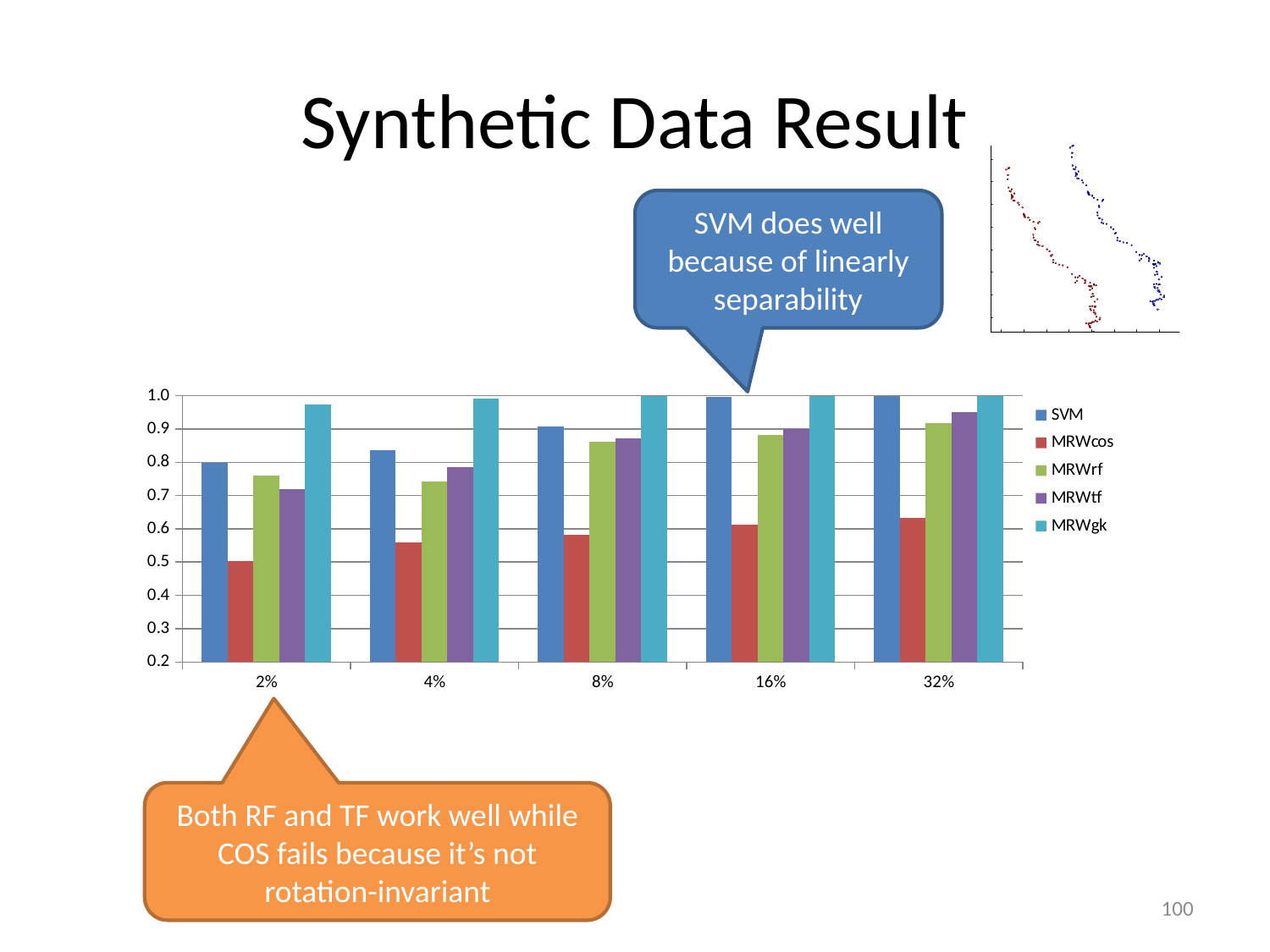
Which series is listed last in the legend? MRWgk Is the value for MRWgk at 2% greater or less than 0.9? greater Which series has the lowest value at 2%? MRWcos How many categories are shown along the x axis? 5 Is the value for MRWcos at 32% greater or less than 0.7? less Is the value for MRWcos at 2% greater or less than 0.6? less Do the MRWcos values rise or fall as the x axis goes from 2% to 32%? rise Which series has the highest value at 2%? MRWgk At 4%, which is larger, MRWrf or MRWtf? MRWtf What kind of chart is shown on the slide? bar chart How many series does the legend list? 5